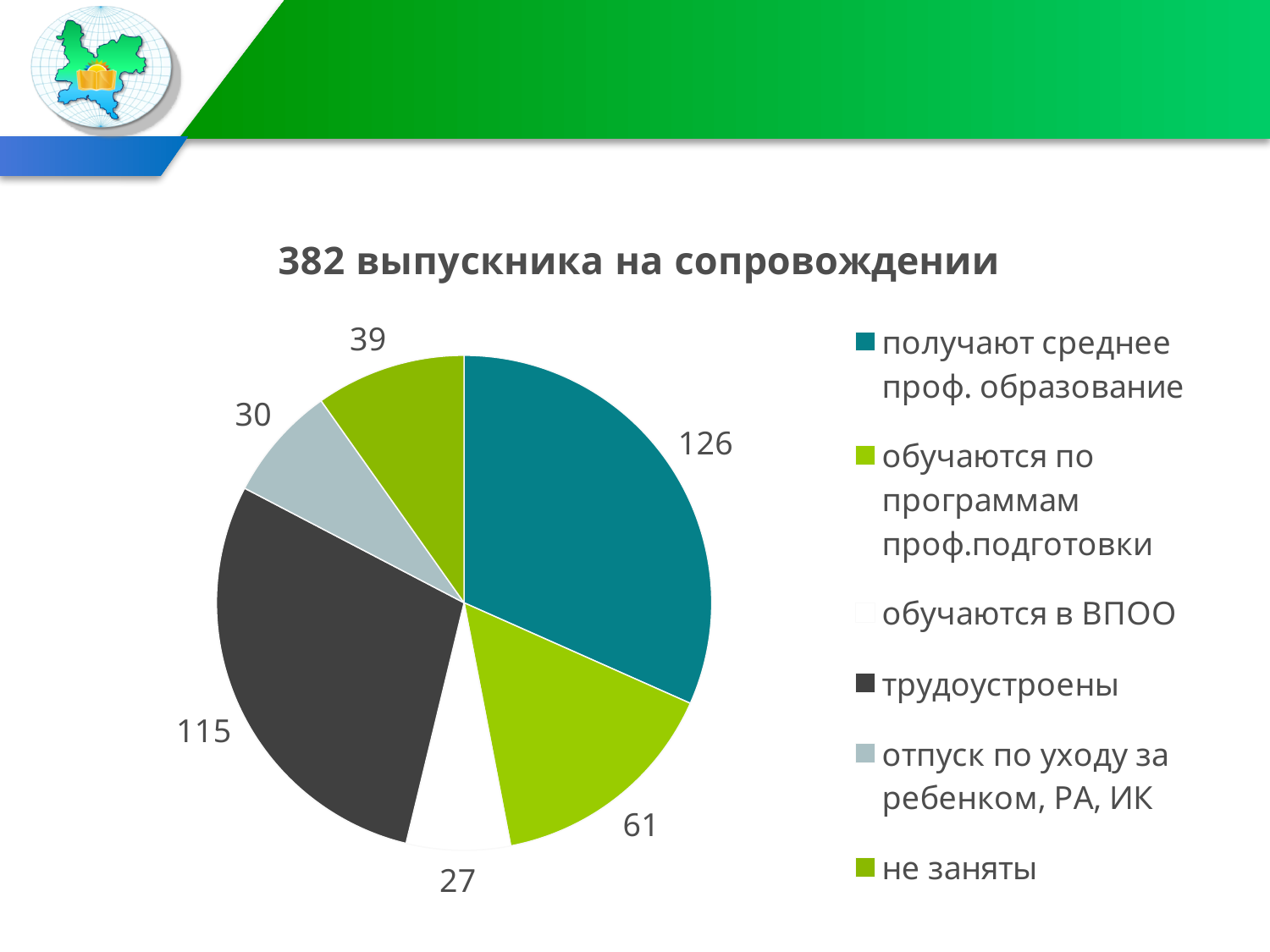
What is the value for "обучаются в ВПОО"? 27 What is the title of the chart? 382 выпускника на сопровождении Which category has the largest slice? получают среднее проф. образование What is the value for "отпуск по уходу за ребенком, РА, ИК"? 30 What is the value for "трудоустроены"? 115 What is the value for "не заняты"? 39 Which category has the smallest slice? обучаются в ВПОО What kind of chart is shown on the slide? pie chart How many slices does the pie chart have? 6 What is the difference between the values for "получают среднее проф. образование" and "трудоустроены"? 11 What is the value for "получают среднее проф. образование"? 126 Which is larger, the value for "обучаются по программам проф.подготовки" or the value for "не заняты"? обучаются по программам проф.подготовки